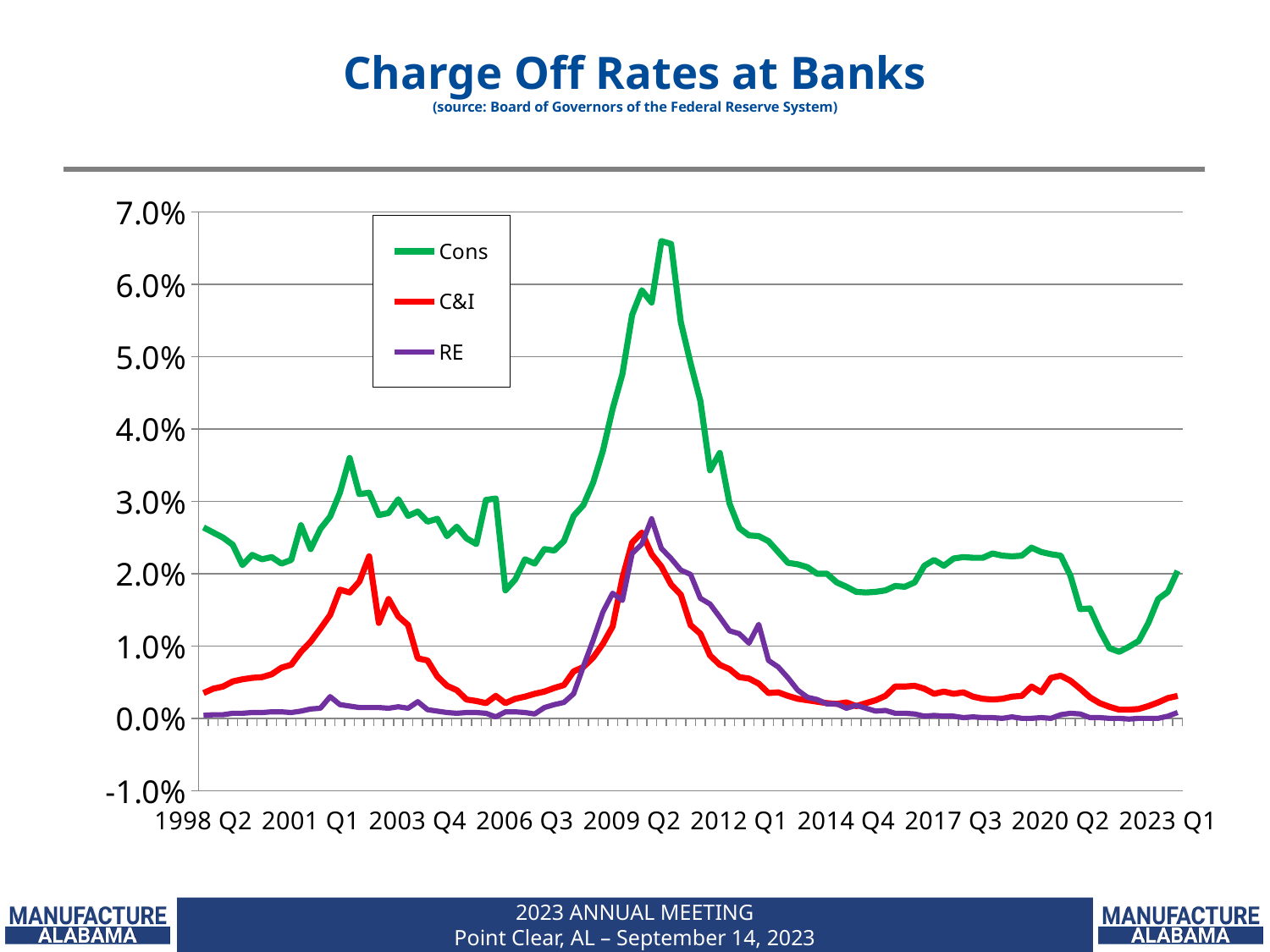
Is the peak value of the Cons series greater or less than 6.0%? greater What kind of chart is shown on the slide? line chart Which colour is used for the C&I series? red How many series does the legend list? 3 Is the value of the C&I series at 1998 Q2 greater or less than 1.0%? less Is the peak value of the RE series greater or less than 3.0%? less Which series reaches the highest value on the chart? Cons Around 2009 Q2, which series has the larger value, Cons or C&I? Cons Does the Cons series rise or fall between 2009 Q2 and 2014 Q4? fall What is the title of the chart? Charge Off Rates at Banks How many labels are shown on the x axis? 10